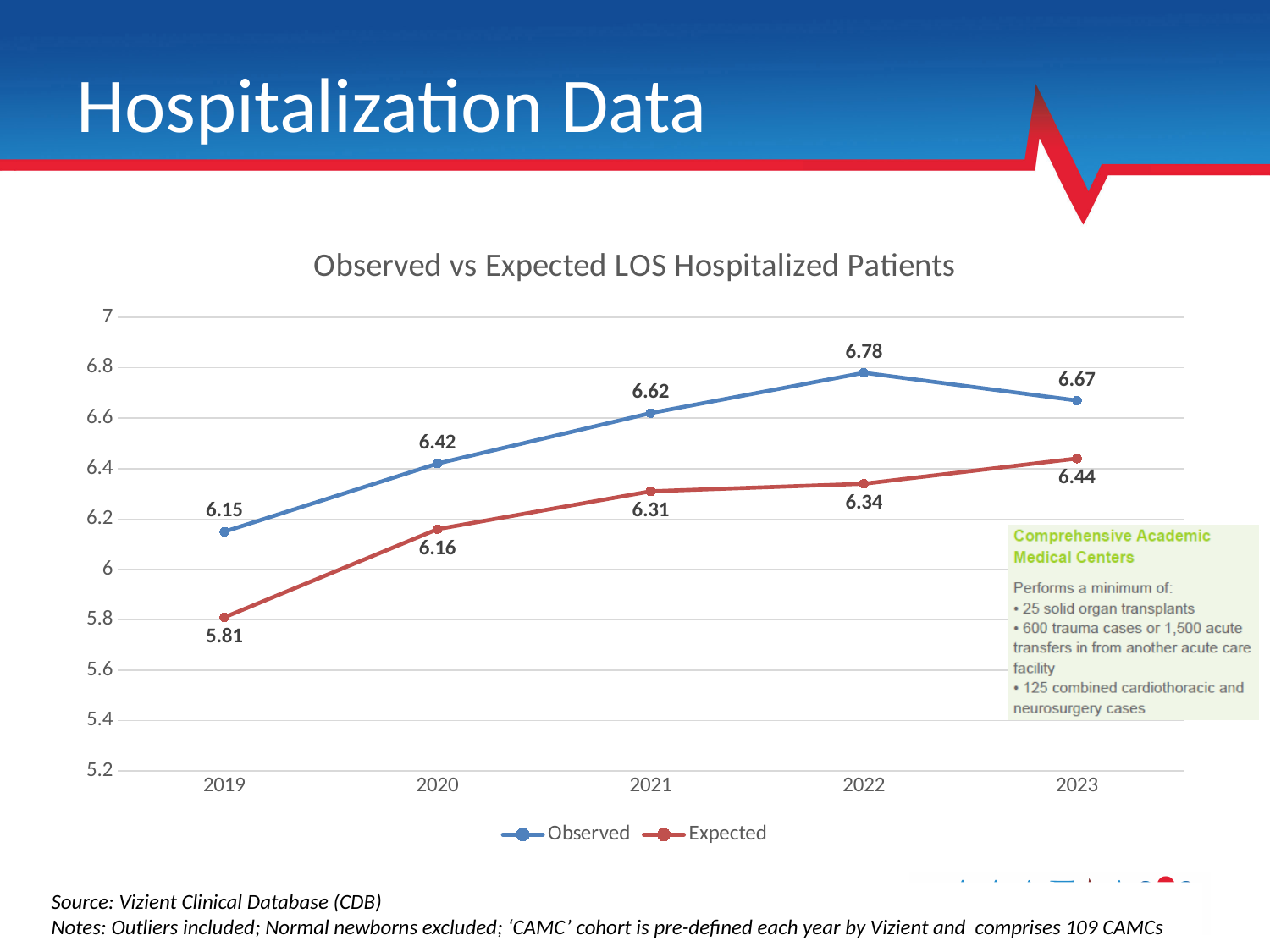
In which year is the Observed LOS highest? 2022 In which year is the Expected LOS lowest? 2019 Is the Expected LOS value for 2019 greater or less than 6? less What is the difference between the Observed and Expected LOS in 2021? 0.31 Which is larger in 2020, the Observed LOS or the Expected LOS? Observed How many years are shown on the x axis? 5 What is the Observed LOS value for 2022? 6.78 What is the Expected LOS value for 2023? 6.44 Does the Expected LOS rise or fall from 2019 to 2023? Rise What kind of chart is shown on the slide? Line chart How many series does the legend list? 2 What is the Expected LOS value for 2019? 5.81